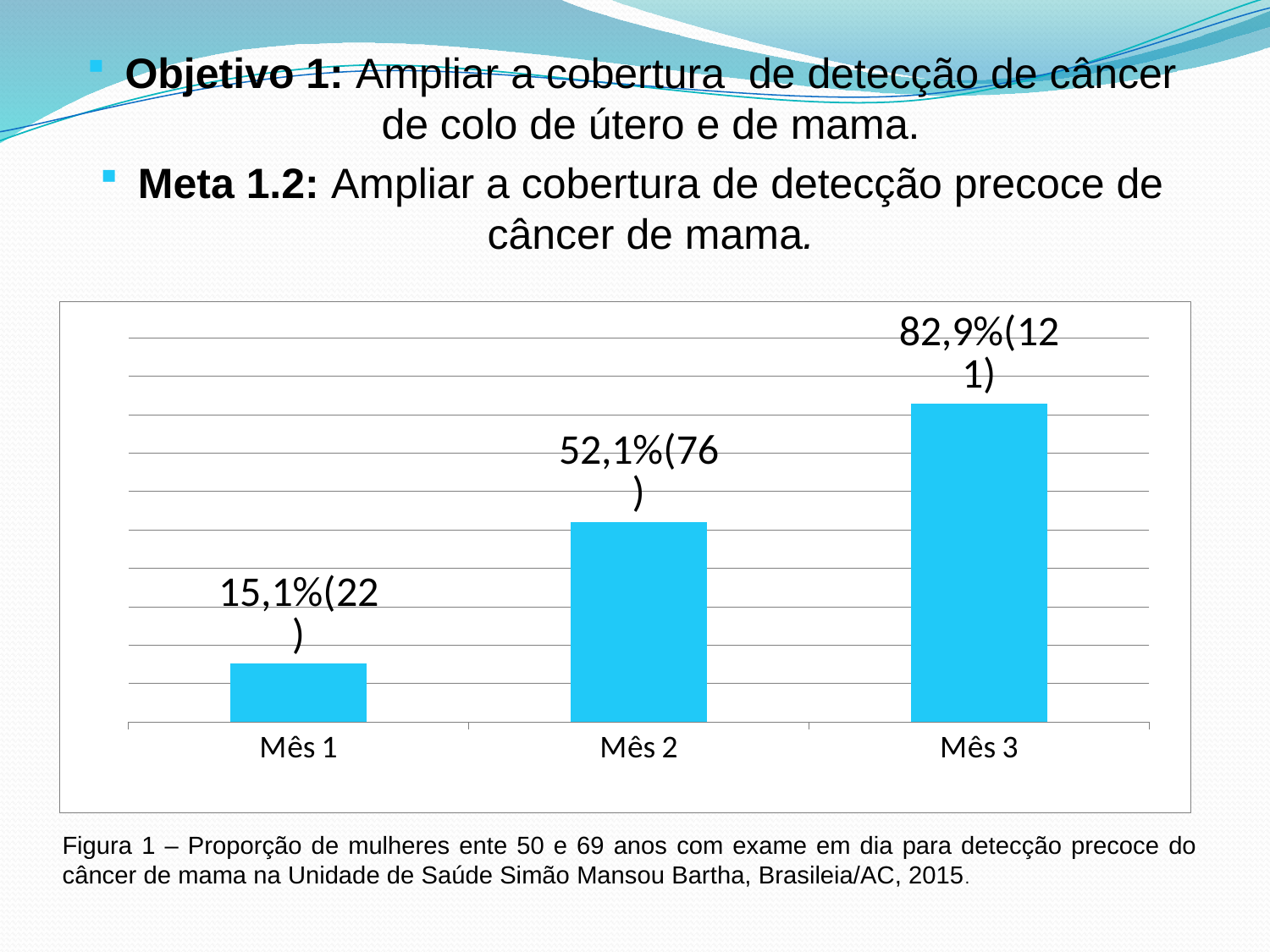
Which is larger, the value for Mês 2 or the value for Mês 3? Mês 3 What is the value shown for Mês 1? 15,1%(22) What is the figure number given in the caption below the chart? Figura 1 Which month has the highest value? Mês 3 What is the difference in percentage between Mês 2 and Mês 1? 37,0% How many months (categories) are shown in the chart? 3 What is the value shown for Mês 3? 82,9%(121) Do the values rise or fall from Mês 1 to Mês 3? Rise What kind of chart is shown on the slide? Bar chart Which month has the lowest value? Mês 1 What is the value shown for Mês 2? 52,1%(76) What is the difference in percentage between Mês 3 and Mês 1? 67,8%